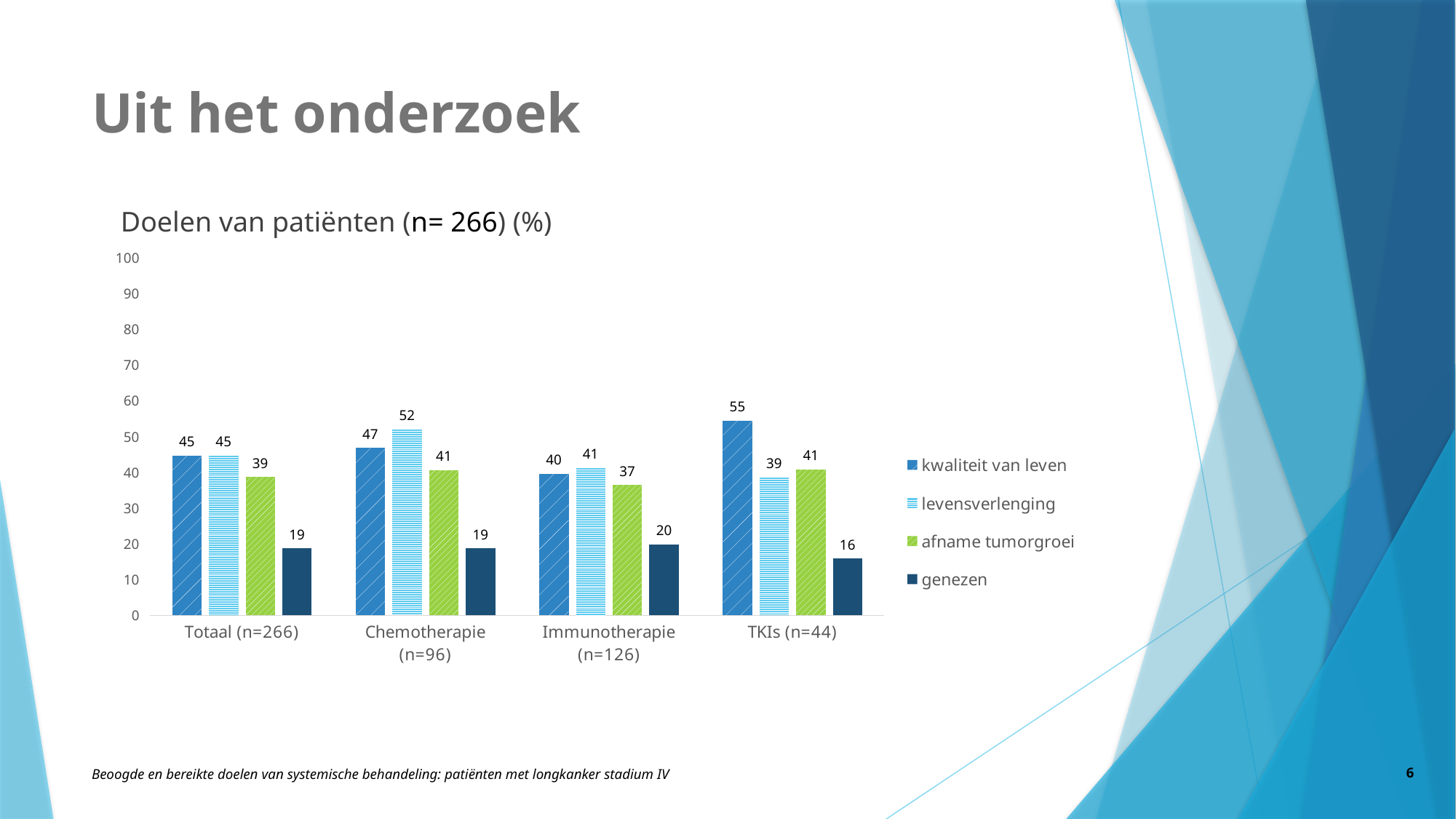
Which group has the highest value for 'kwaliteit van leven'? TKIs (n=44) What is the value for 'levensverlenging' in the Chemotherapie (n=96) group? 52 Which is larger in the Chemotherapie (n=96) group: 'kwaliteit van leven' or 'levensverlenging'? levensverlenging Which group has the lowest value for 'genezen'? TKIs (n=44) What is the value for 'genezen' in the Immunotherapie (n=126) group? 20 What is the title of the chart? Doelen van patiënten (n= 266) (%) What kind of chart is shown on the slide? Bar chart What is the difference between 'kwaliteit van leven' and 'genezen' in the TKIs (n=44) group? 39 What is the value for 'kwaliteit van leven' in the TKIs (n=44) group? 55 How many groups are shown on the x axis? 4 How many series does the legend list? 4 What is the value for 'afname tumorgroei' in the Totaal (n=266) group? 39